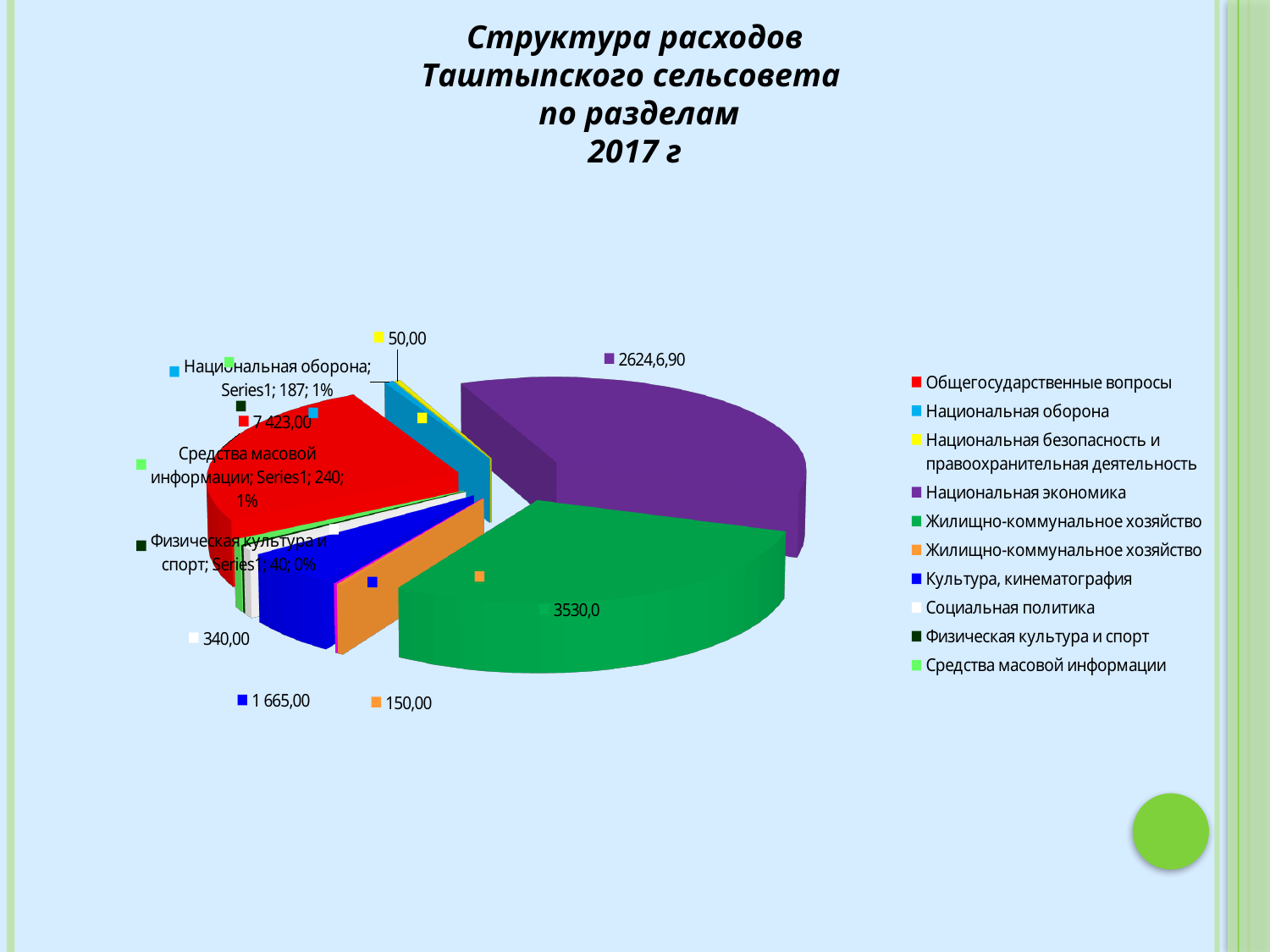
How many entries does the legend list? 10 Which category has the largest slice of the pie? Национальная экономика What value is labelled for Средства масовой информации? 240 What value is labelled for Социальная политика? 340,00 What kind of chart is shown on the slide? pie chart Which is larger, the value for Культура, кинематография or the value for Социальная политика? Культура, кинематография What value is labelled for Национальная оборона? 187 What value is labelled for Общегосударственные вопросы? 7 423,00 What value is labelled for Культура, кинематография? 1 665,00 What share of the pie is labelled for Национальная оборона? 1% What value is labelled for Физическая культура и спорт? 40